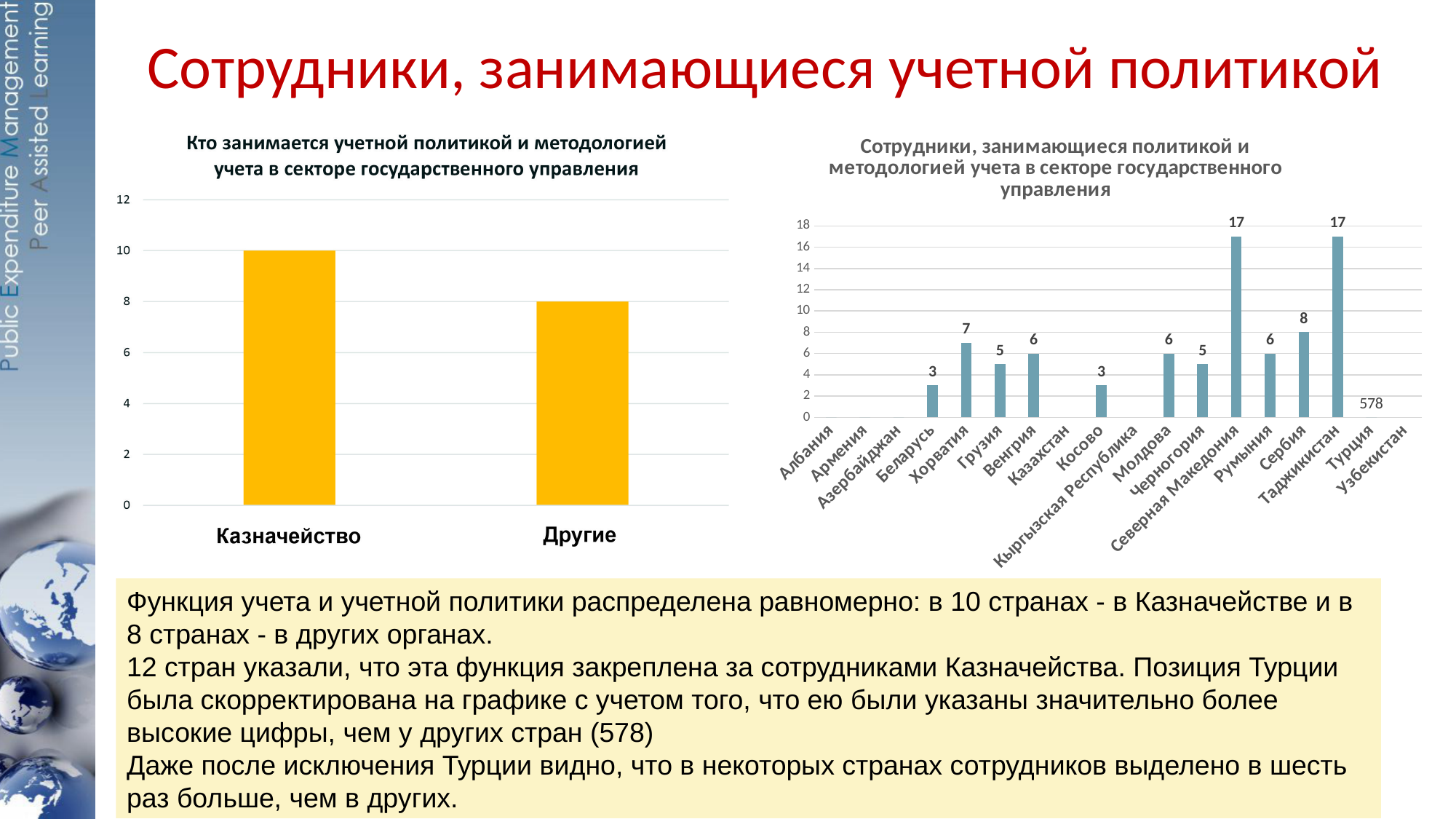
In the right chart, what is the value for Сербия? 8 In the right chart, what is the value for Северная Македония? 17 In the right chart, which has the larger value, Сербия or Беларусь? Сербия In the right chart, what number is printed next to Турция? 578 In the left chart, which category has the higher value, Казначейство or Другие? Казначейство How many categories are shown in the left chart? 2 In the right chart titled «Сотрудники, занимающиеся политикой и методологией учета в секторе государственного управления», what is the value for Хорватия? 7 In the left chart, what is the value for Другие? 8 In the right chart, what is the difference between the values for Сербия and Беларусь? 5 In the left chart, what is the value for Казначейство? 10 In the left chart, what is the difference between the values for Казначейство and Другие? 2 What kind of chart is the left chart titled «Кто занимается учетной политикой и методологией учета в секторе государственного управления»? Bar chart